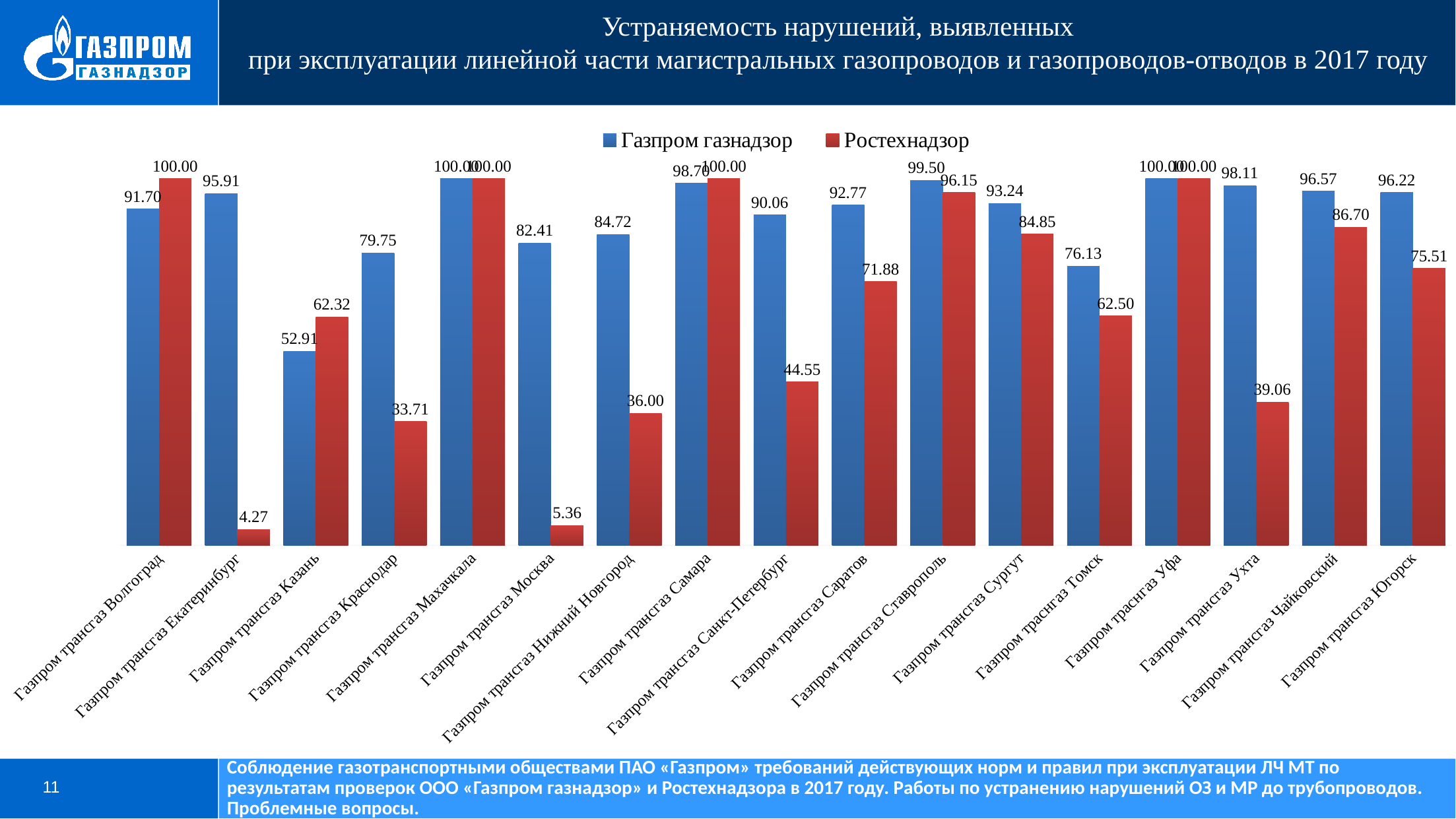
What is the Газпром газнадзор value for Газпром трансгаз Краснодар? 79.75 Which series is shown in red in the legend? Ростехнадзор What is the Ростехнадзор value for Газпром трансгаз Екатеринбург? 4.27 What kind of chart is shown on the slide? bar chart What is the difference between the Газпром газнадзор and Ростехнадзор values for Газпром трансгаз Томск? 13.63 How many series does the legend list? 2 How many categories (companies) are shown on the x axis? 17 Which category has the lowest Ростехнадзор value? Газпром трансгаз Екатеринбург What is the difference between the Газпром газнадзор and Ростехнадзор values for Газпром трансгаз Москва? 77.05 For Газпром трансгаз Казань, which series has the larger value: Газпром газнадзор or Ростехнадзор? Ростехнадзор What is the Ростехнадзор value for Газпром трансгаз Ухта? 39.06 Which category has the lowest Газпром газнадзор value? Газпром трансгаз Казань